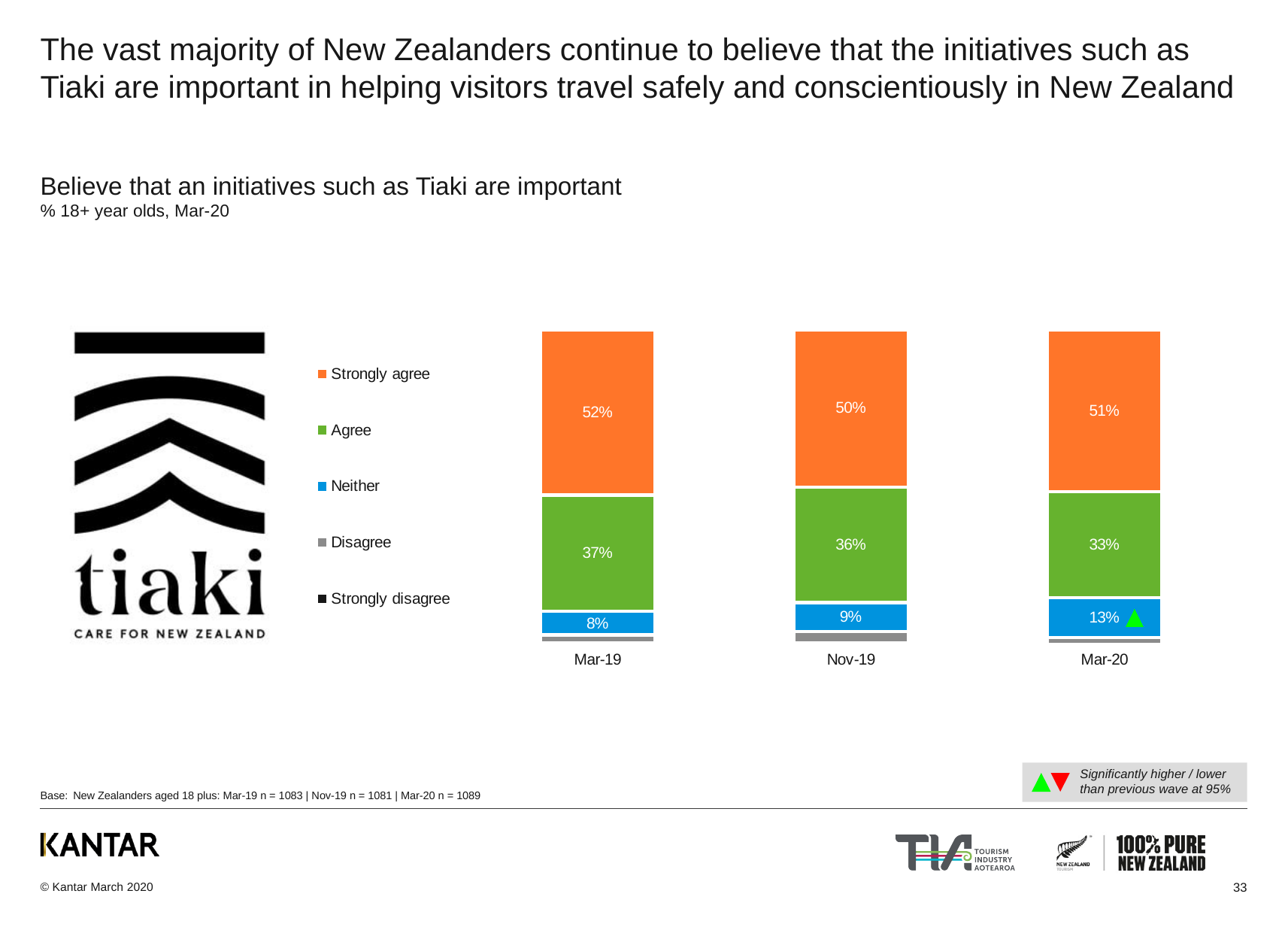
By how many percentage points did the 'Agree' share fall from Mar-19 to Mar-20? 4 percentage points What is the 'Neither' value for Nov-19? 9% What percentage of respondents strongly agreed in Mar-19? 52% How many series does the legend list? 5 What percentage of respondents answered 'Agree' in Mar-20? 33% In which period was the 'Strongly agree' share highest? Mar-19 What type of chart is shown on the slide? Stacked bar chart How many time periods are shown on the x axis? 3 What is the difference between the 'Neither' values for Mar-19 and Mar-20? 5 percentage points In which period was the 'Agree' share lowest? Mar-20 Which is larger, the 'Strongly agree' share in Nov-19 or in Mar-20? Mar-20 What is the 'Neither' value for Mar-20? 13%